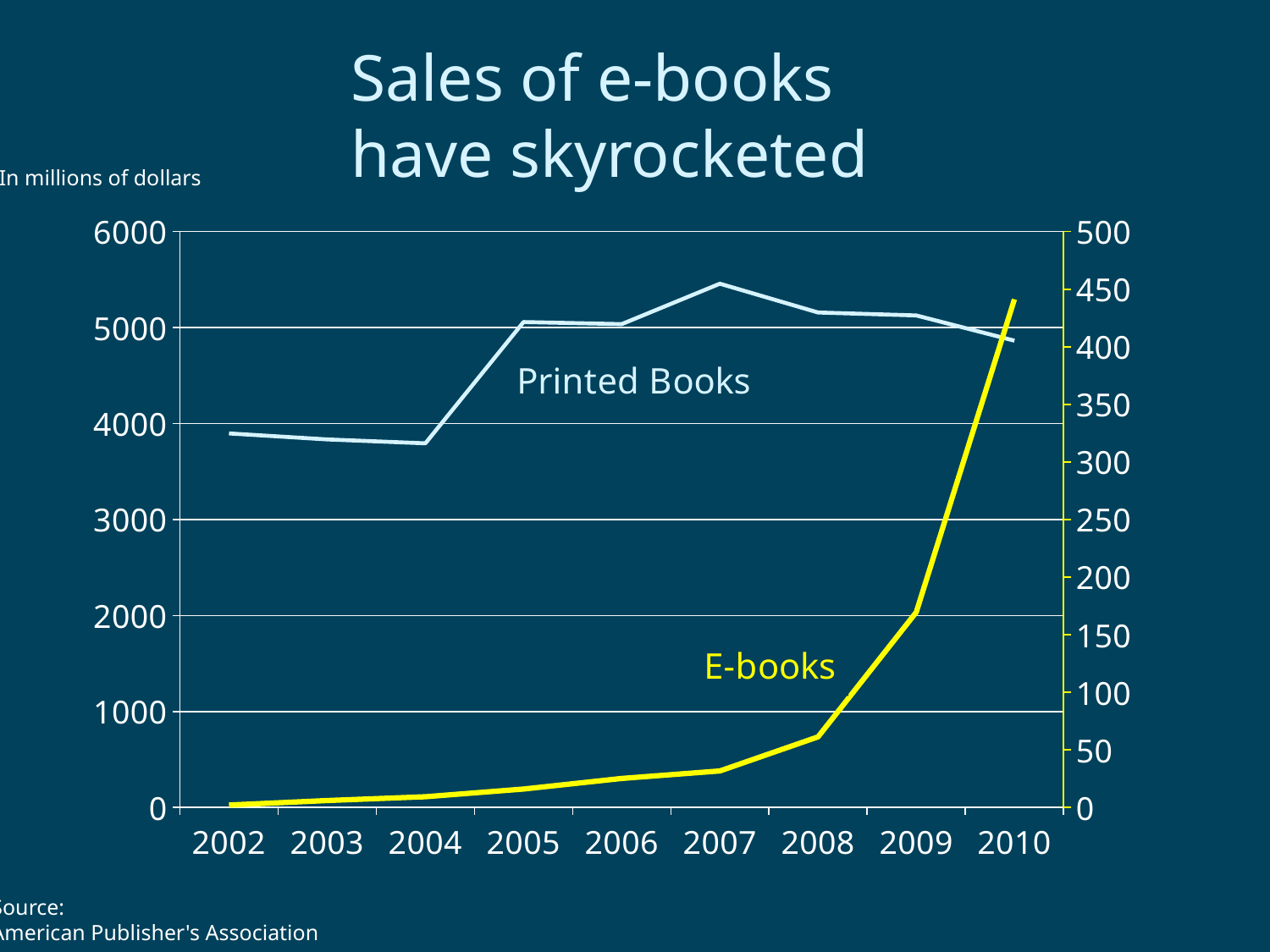
In which year are Printed Books sales highest? 2007 Is the Printed Books value for 2010 greater or less than 5000? less Do E-books sales rise or fall from 2002 to 2010? rise What kind of chart is shown on the slide? line chart How many data series are plotted on the chart? 2 How many years are plotted along the x axis? 9 What is the title of the chart? Sales of e-books have skyrocketed In which year are E-books sales highest? 2010 Is the E-books value for 2010 greater or less than 400 on the right axis? greater Is the E-books value for 2008 greater or less than 100 on the right axis? less Which year has the larger Printed Books value, 2005 or 2007? 2007